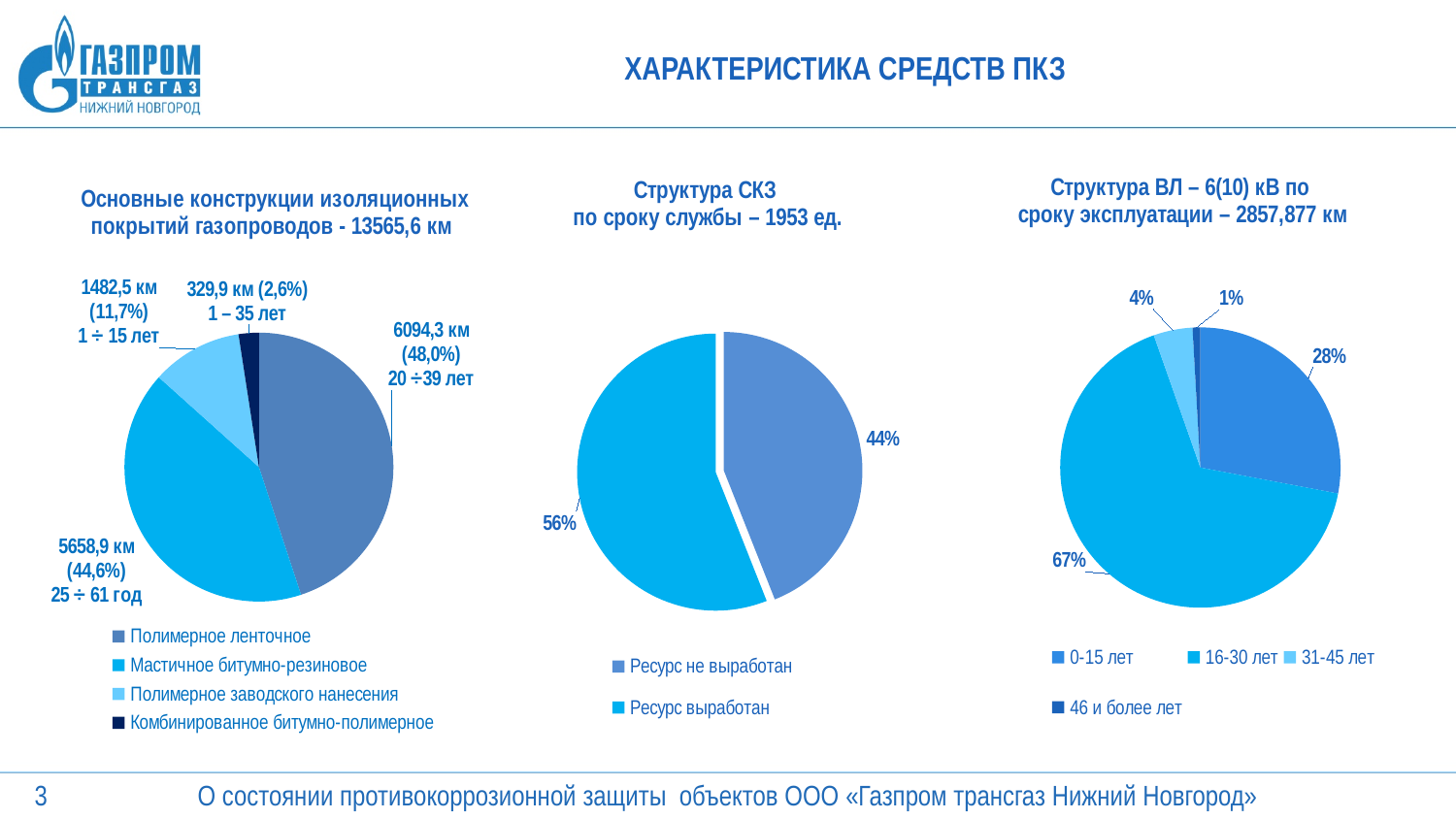
In the right chart (Структура ВЛ – 6(10) кВ по сроку эксплуатации), which category has the smallest share? 46 и более лет In the left chart (Основные конструкции изоляционных покрытий газопроводов), which category has the smallest share? Комбинированное битумно-полимерное In the middle chart (Структура СКЗ по сроку службы), what share is Ресурс выработан? 56% In the left chart (Основные конструкции изоляционных покрытий газопроводов), what is the value for Мастичное битумно-резиновое? 5658,9 км (44,6%) How many pie charts are shown on the slide? 3 What kind of chart is the middle chart (Структура СКЗ по сроку службы)? Pie chart In the right chart (Структура ВЛ – 6(10) кВ по сроку эксплуатации), what share is 16-30 лет? 67% In the left chart (Основные конструкции изоляционных покрытий газопроводов), what is the difference in km between Полимерное ленточное and Мастичное битумно-резиновое? 435,4 км In the middle chart (Структура СКЗ по сроку службы), which is larger: Ресурс не выработан or Ресурс выработан? Ресурс выработан In the left chart (Основные конструкции изоляционных покрытий газопроводов), what is the value for Полимерное ленточное? 6094,3 км (48,0%) In the right chart (Структура ВЛ – 6(10) кВ по сроку эксплуатации), what share is 0-15 лет? 28% In the left chart (Основные конструкции изоляционных покрытий газопроводов), how many categories does the legend list? 4